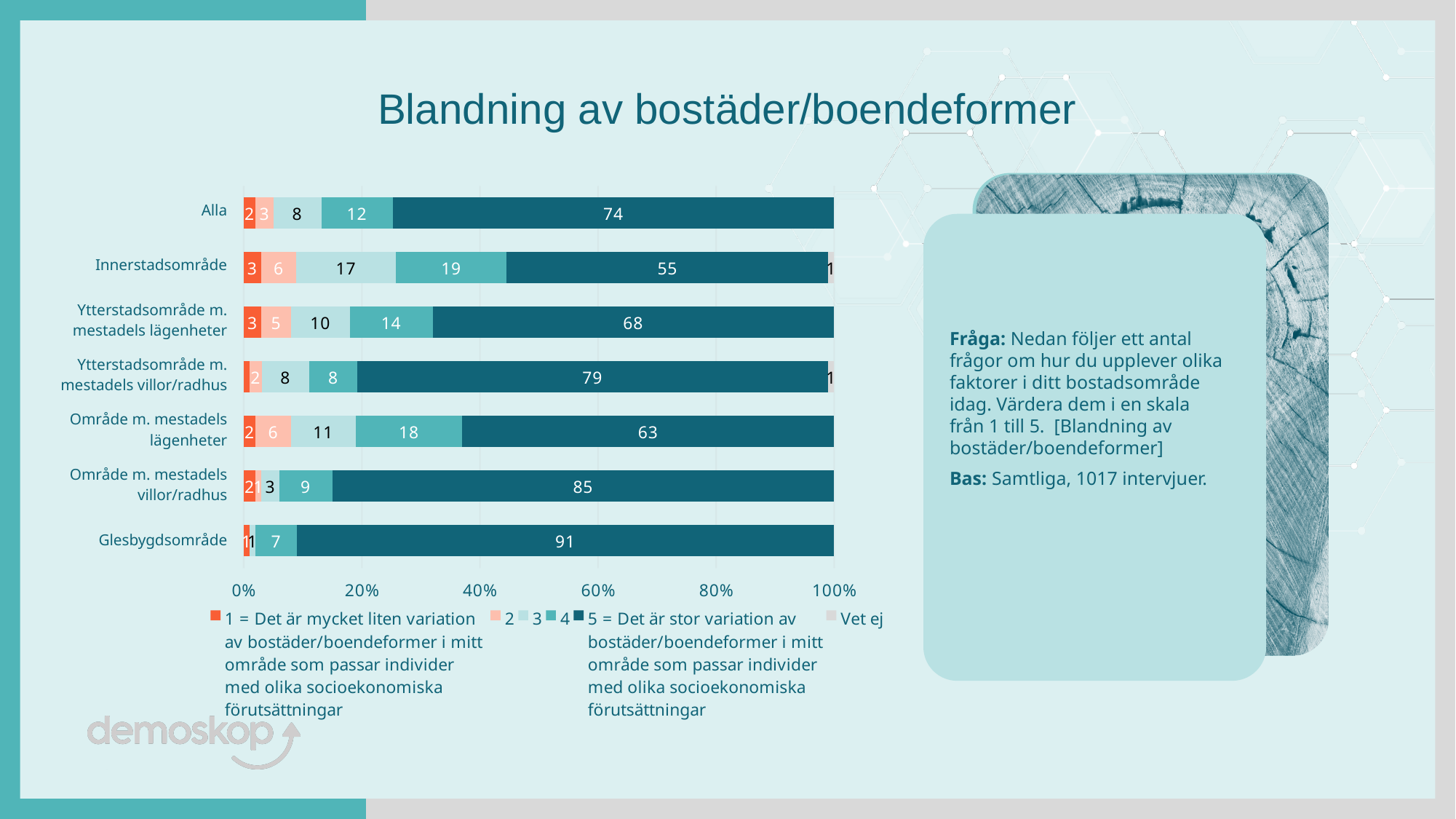
What is the difference between the series 5 values for Område m. mestadels villor/radhus and Område m. mestadels lägenheter? 22 What is the value for series 5 for Glesbygdsområde? 91 What is the value for series 3 for Ytterstadsområde m. mestadels lägenheter? 10 What is the value for series 4 for Innerstadsområde? 19 How many series does the legend list? 6 What kind of chart is shown on the slide? Stacked bar chart Which category has the lowest value for series 5? Innerstadsområde Which is larger: the series 4 value for Innerstadsområde or for Alla? Innerstadsområde What is the value for '5 = Det är stor variation' for Alla? 74 What is the title of the chart on the slide? Blandning av bostäder/boendeformer Which category has the highest value for series 5? Glesbygdsområde How many categories are shown on the y axis of the chart? 7